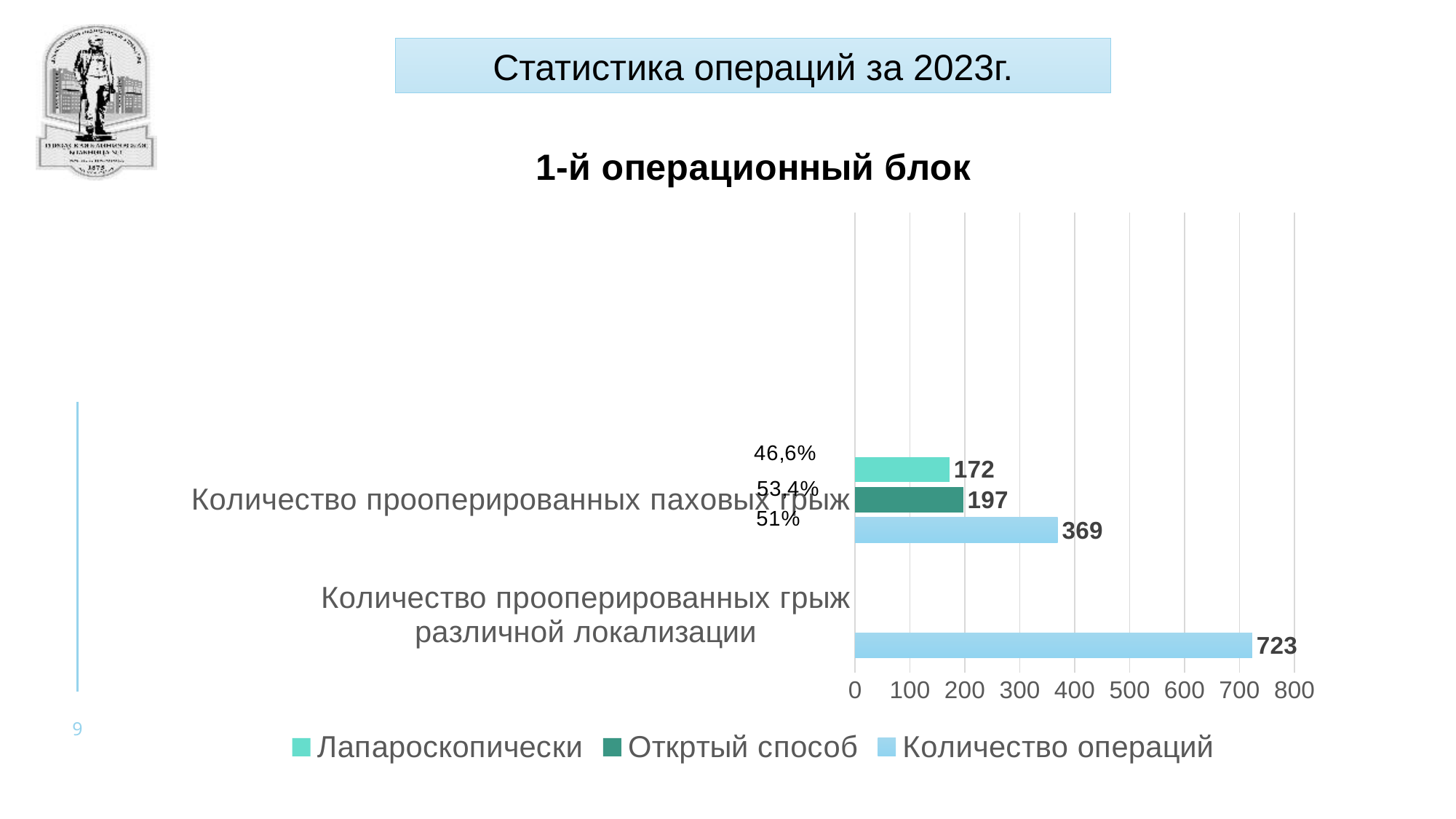
What is the difference between the 'Количество операций' values for the two categories? 354 Which category has the highest 'Количество операций' value? Количество прооперированных грыж различной локализации What is the subtitle shown above the chart? 1-й операционный блок What is the value of 'Количество операций' for 'Количество прооперированных паховых грыж'? 369 Is the 'Количество операций' value for 'Количество прооперированных грыж различной локализации' greater or less than 700? greater How many series does the legend list? 3 What is the difference between 'Открытый способ' and 'Лапароскопически' for 'Количество прооперированных паховых грыж'? 25 What kind of chart is shown on the slide? bar chart What is the value of 'Лапароскопически' for 'Количество прооперированных паховых грыж'? 172 What is the value of 'Открытый способ' for 'Количество прооперированных паховых грыж'? 197 Which is larger for 'Количество прооперированных паховых грыж': 'Лапароскопически' or 'Открытый способ'? Открытый способ What is the value of 'Количество операций' for 'Количество прооперированных грыж различной локализации'? 723